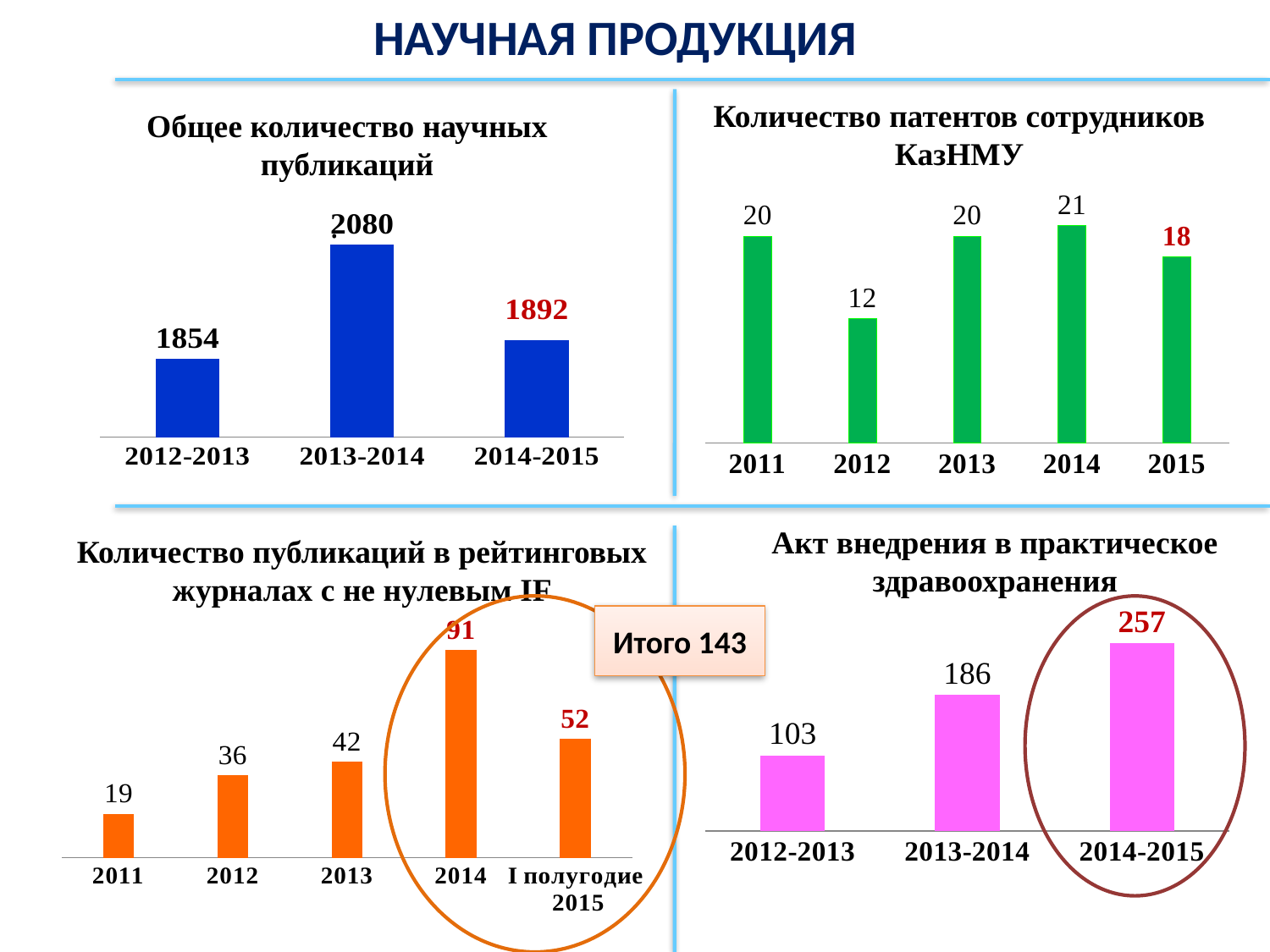
In the chart 'Количество патентов сотрудников КазНМУ', which year has the highest value? 2014 What type of chart is 'Акт внедрения в практическое здравоохранения'? bar chart In the chart 'Общее количество научных публикаций', which period has the lowest value? 2012-2013 How many years are shown in the chart 'Количество патентов сотрудников КазНМУ'? 5 In the chart 'Акт внедрения в практическое здравоохранения', do the values rise or fall from 2012-2013 to 2014-2015? rise In the chart 'Общее количество научных публикаций', what is the difference between the values for 2013-2014 and 2014-2015? 188 In the chart 'Количество публикаций в рейтинговых журналах с не нулевым IF', what is the total of the values for 2014 and I полугодие 2015? 143 In the chart 'Количество публикаций в рейтинговых журналах с не нулевым IF', is the value for 2012 or 2013 larger? 2013 In the chart 'Акт внедрения в практическое здравоохранения', what is the value for 2012-2013? 103 In the chart 'Количество публикаций в рейтинговых журналах с не нулевым IF', what is the value for 2014? 91 In the chart 'Общее количество научных публикаций', what is the value for 2013-2014? 2080 In the chart 'Количество патентов сотрудников КазНМУ', what is the value for 2012? 12